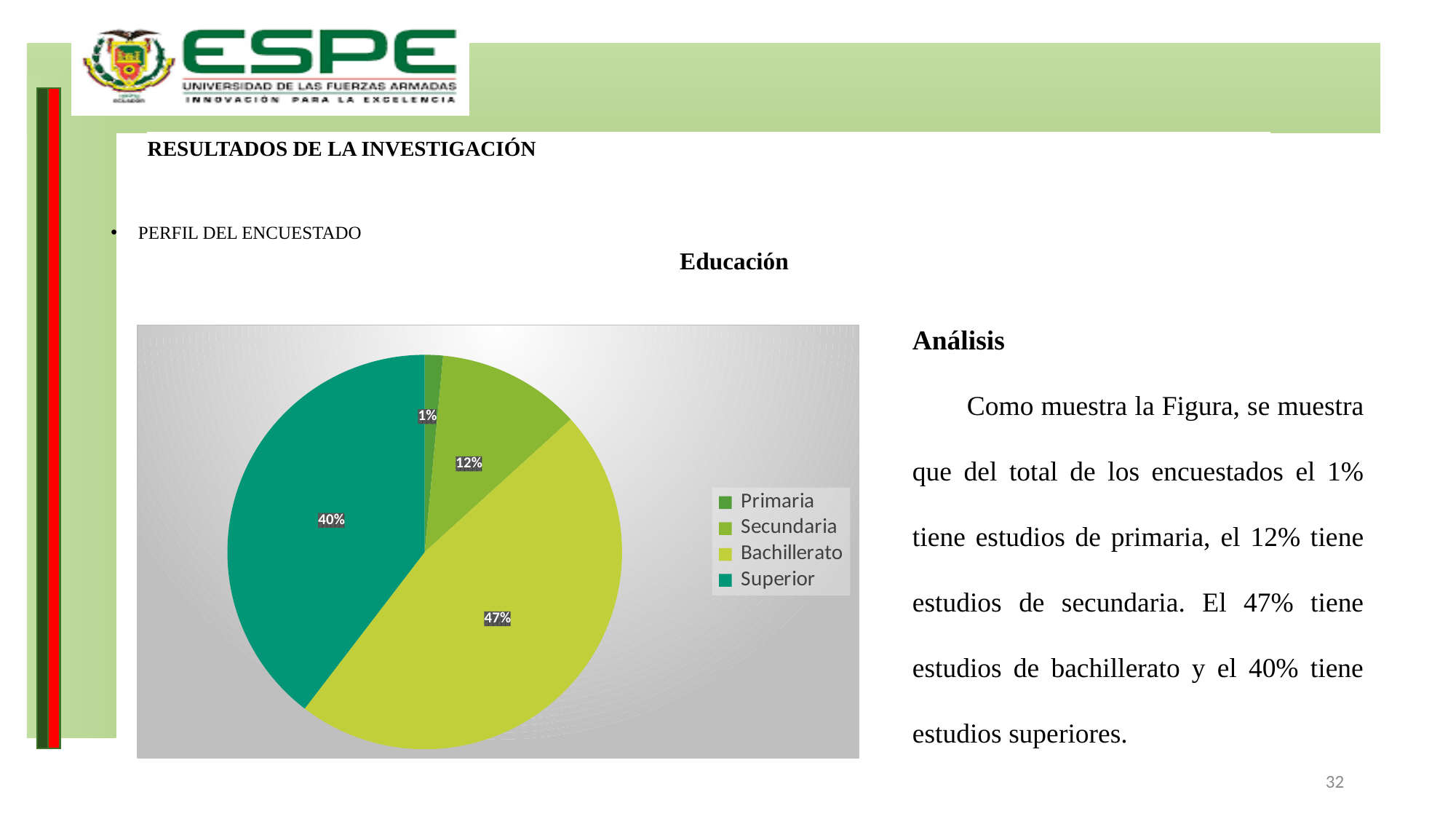
What percentage of respondents have Superior education? 40% What percentage of respondents have Bachillerato education? 47% What percentage of respondents have Primaria education? 1% How many categories does the pie chart show? 4 What is the difference in percentage points between Bachillerato and Superior? 7 What is the combined share of Primaria and Secundaria? 13% Which education level has the smallest share of the pie? Primaria What kind of chart is shown on the slide? pie chart Which is larger, the share for Secundaria or the share for Superior? Superior What percentage of respondents have Secundaria education? 12% Which education level has the largest share of the pie? Bachillerato What is the title of the chart? Educación